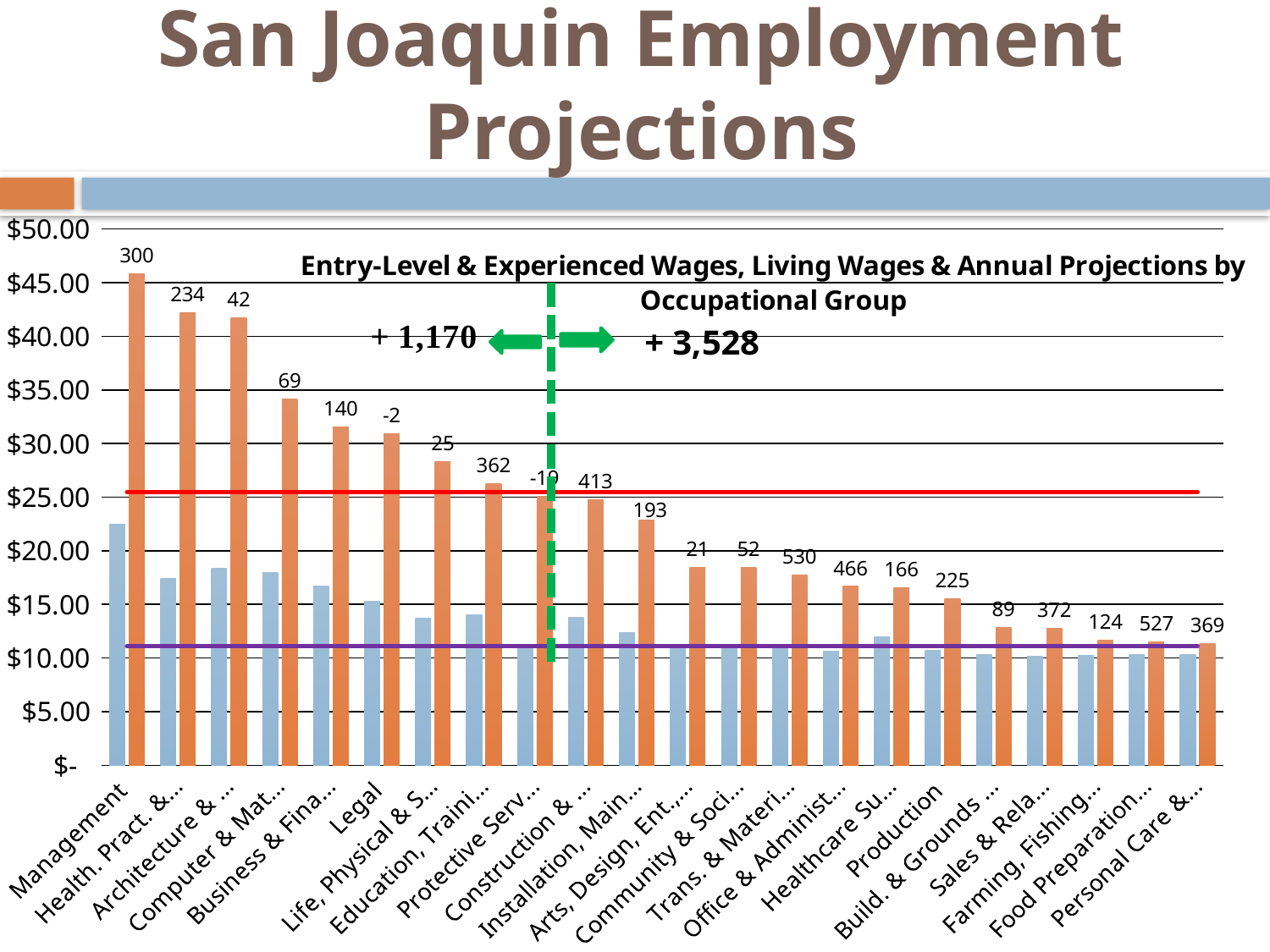
What is the difference between the data labels for Trans. & Materi... (530) and Office & Administ... (466)? 64 Is the orange bar for Personal Care &... greater or less than $15.00? less Which occupational group has the highest data label value? Trans. & Materi... How many occupational groups are shown on the x axis? 22 Which has the larger data label, Construction & ... or Education, Traini...? Construction & ... Which occupational group has the lowest data label value? Protective Serv... What kind of chart is shown on the slide? bar chart What is the data label shown above the Food Preparation... bars? 527 What is the data label shown above the Legal bars? -2 Which occupational group has the tallest orange bar? Management Is the orange bar for Management greater or less than $40.00? greater What is the data label shown above the Management bars? 300